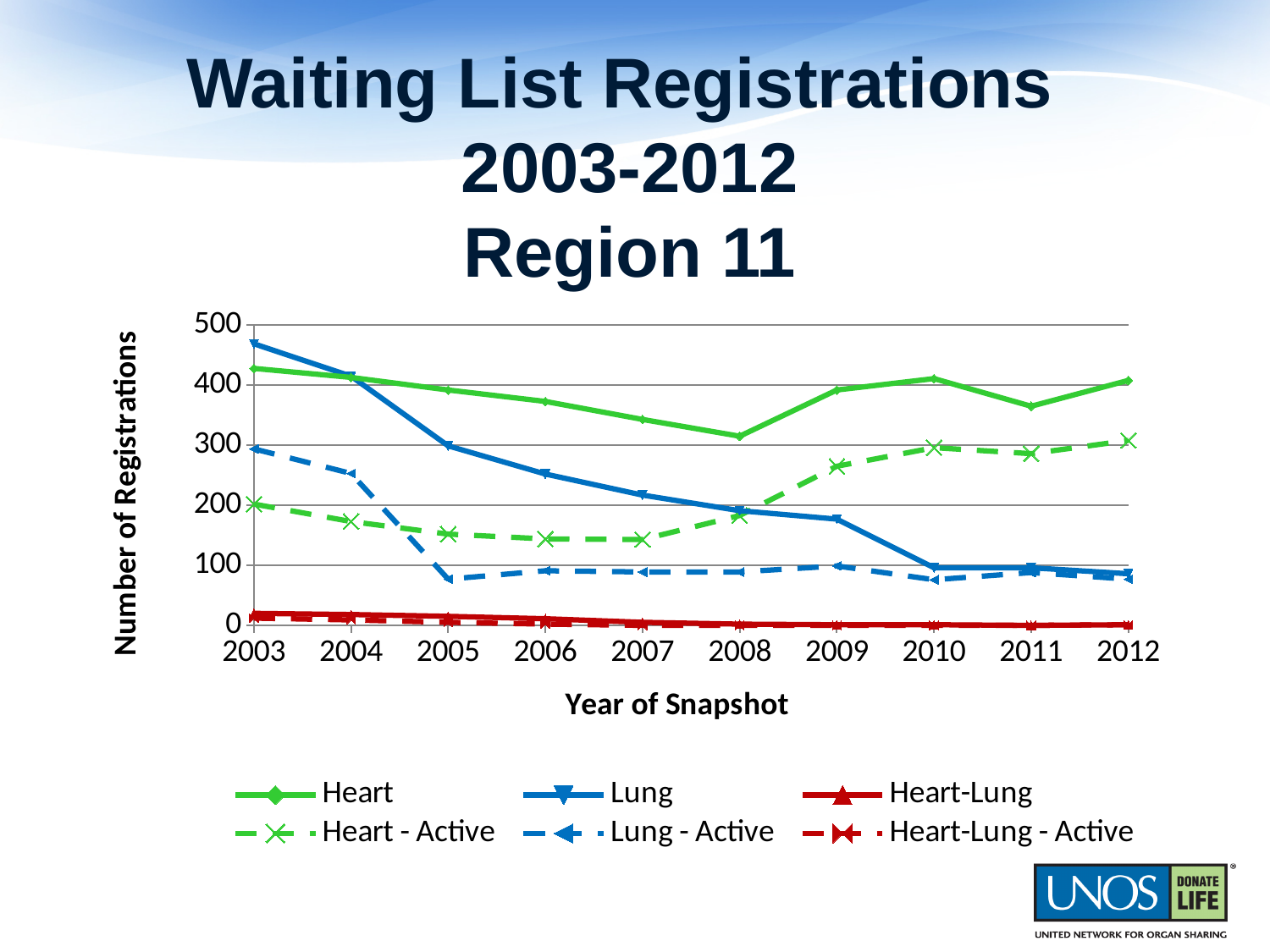
In 2012, which is larger, Heart or Lung? Heart Is the value for Heart - Active in 2007 greater or less than 200? less Does the Lung series rise or fall from 2003 to 2012? fall What kind of chart is shown on the slide? line chart What is the title of the x axis? Year of Snapshot Is the value for Lung in 2003 greater or less than 400? greater In which year is the Lung series at its highest? 2003 How many series does the legend list? 6 How many years are plotted along the x axis? 10 In 2003, which is larger, Heart or Lung? Lung In which year is the Heart series at its lowest? 2008 Is the value for Lung in 2012 greater or less than 100? less